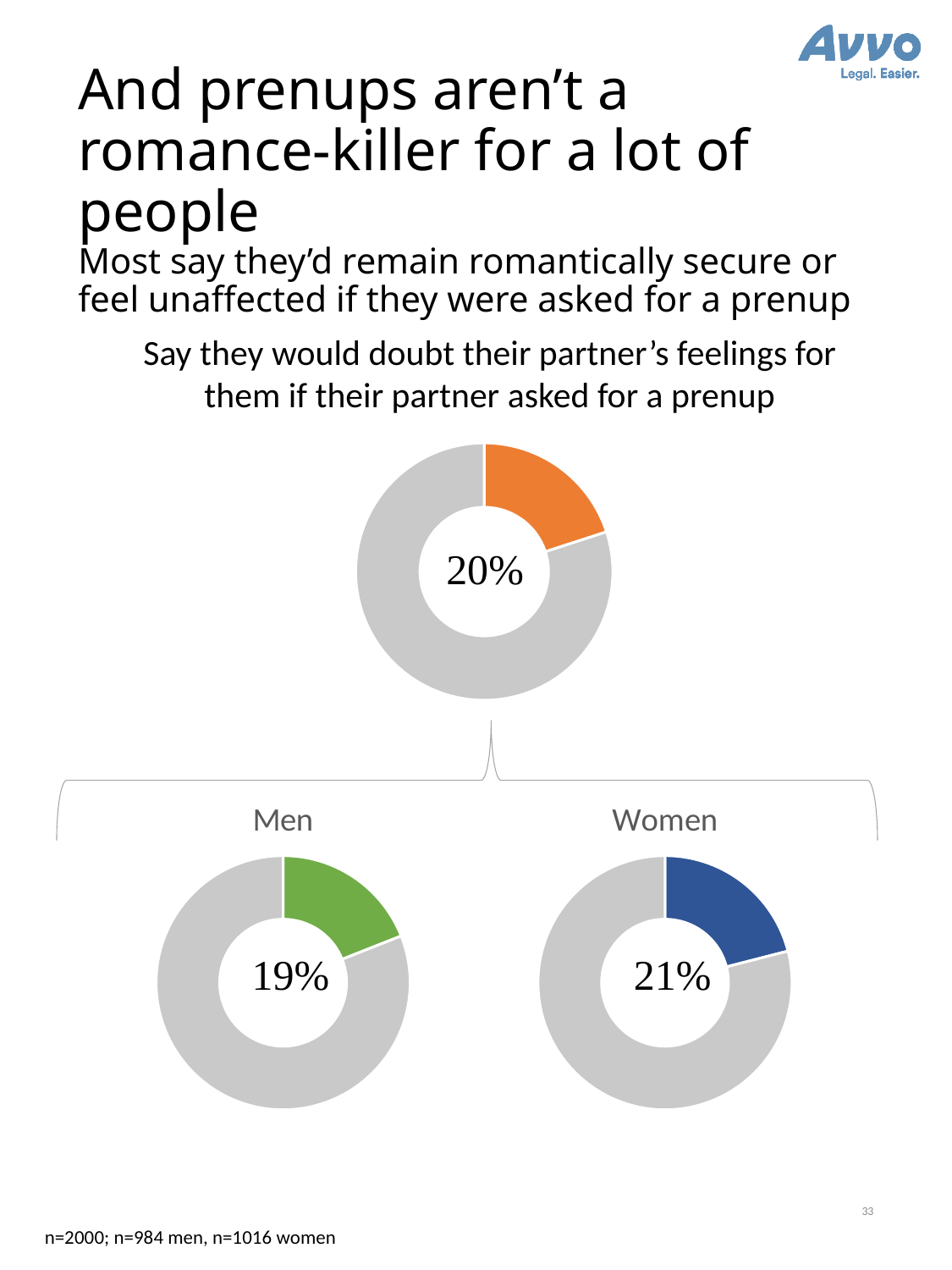
How many donut charts are shown on the slide? 3 Is the value shown in the Women donut chart greater or less than 20%? greater What kind of chart is used to show the percentages on this slide? Donut (pie) chart Comparing the Men and Women donut charts, which group has the lower percentage who would doubt their partner's feelings? Men Comparing the Men and Women donut charts, which group has the higher percentage who would doubt their partner's feelings? Women What colour is the highlighted segment in the Men donut chart? Green In the top donut chart, what share of the ring is shown in orange? 20% What colour is the highlighted segment in the Women donut chart? Blue In the Men donut chart, what percentage of men say they would doubt their partner's feelings if asked for a prenup? 19% What is the difference in percentage points between the Women donut chart value and the Men donut chart value? 2 percentage points In the Women donut chart, what percentage of women say they would doubt their partner's feelings if asked for a prenup? 21% In the top donut chart, what percentage say they would doubt their partner's feelings if their partner asked for a prenup? 20%